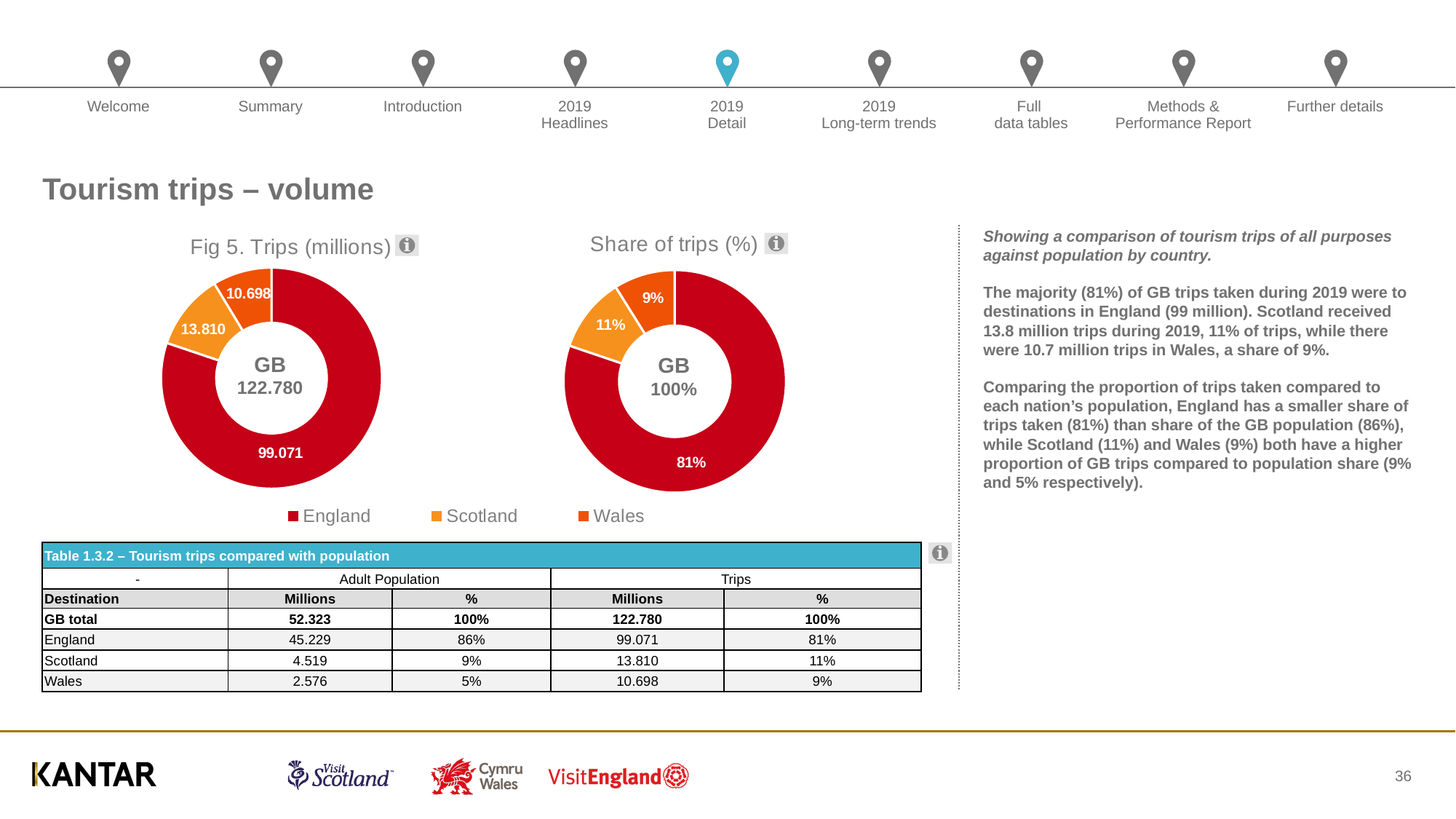
In the 'Fig 5. Trips (millions)' chart, which country has the highest number of trips? England In the 'Fig 5. Trips (millions)' chart, what is the value for Scotland? 13.810 In the 'Share of trips (%)' chart, what is the share for Wales? 9% In the 'Fig 5. Trips (millions)' chart, what is the GB total shown in the centre? 122.780 In the 'Share of trips (%)' chart, what is the share for England? 81% In the 'Fig 5. Trips (millions)' chart, what is the value for England? 99.071 What kind of chart is 'Fig 5. Trips (millions)'? Doughnut (pie) chart In the 'Fig 5. Trips (millions)' chart, which country has the lowest number of trips? Wales In the 'Fig 5. Trips (millions)' chart, what is the value for Wales? 10.698 In the 'Fig 5. Trips (millions)' chart, what is the difference between the values for Scotland and Wales? 3.112 How many entries does the legend below the two charts list? 3 In the 'Share of trips (%)' chart, what is the share for Scotland? 11%